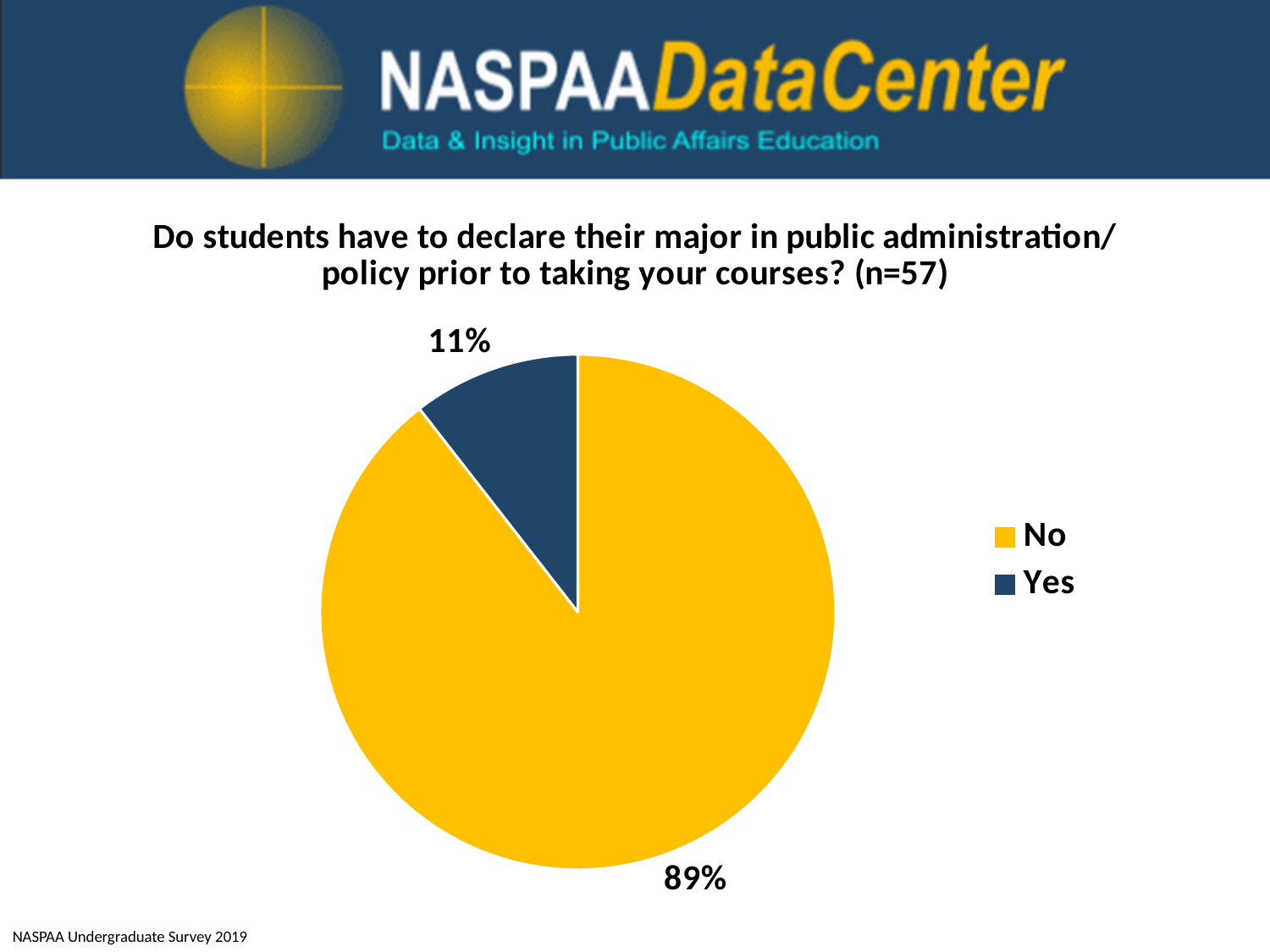
Which response has the largest share of the pie? No What percentage of respondents answered "No"? 89% How many entries does the legend list? 2 Which response has the smallest share of the pie? Yes What is the difference in percentage points between the "No" and "Yes" responses? 78 Which is larger, the share for "Yes" or the share for "No"? No Which colour represents the "Yes" response in the pie chart? dark blue How many slices does the pie chart have? 2 What percentage of respondents answered "Yes"? 11% What kind of chart is shown on the slide? pie chart What is the sample size (n) stated in the chart title? 57